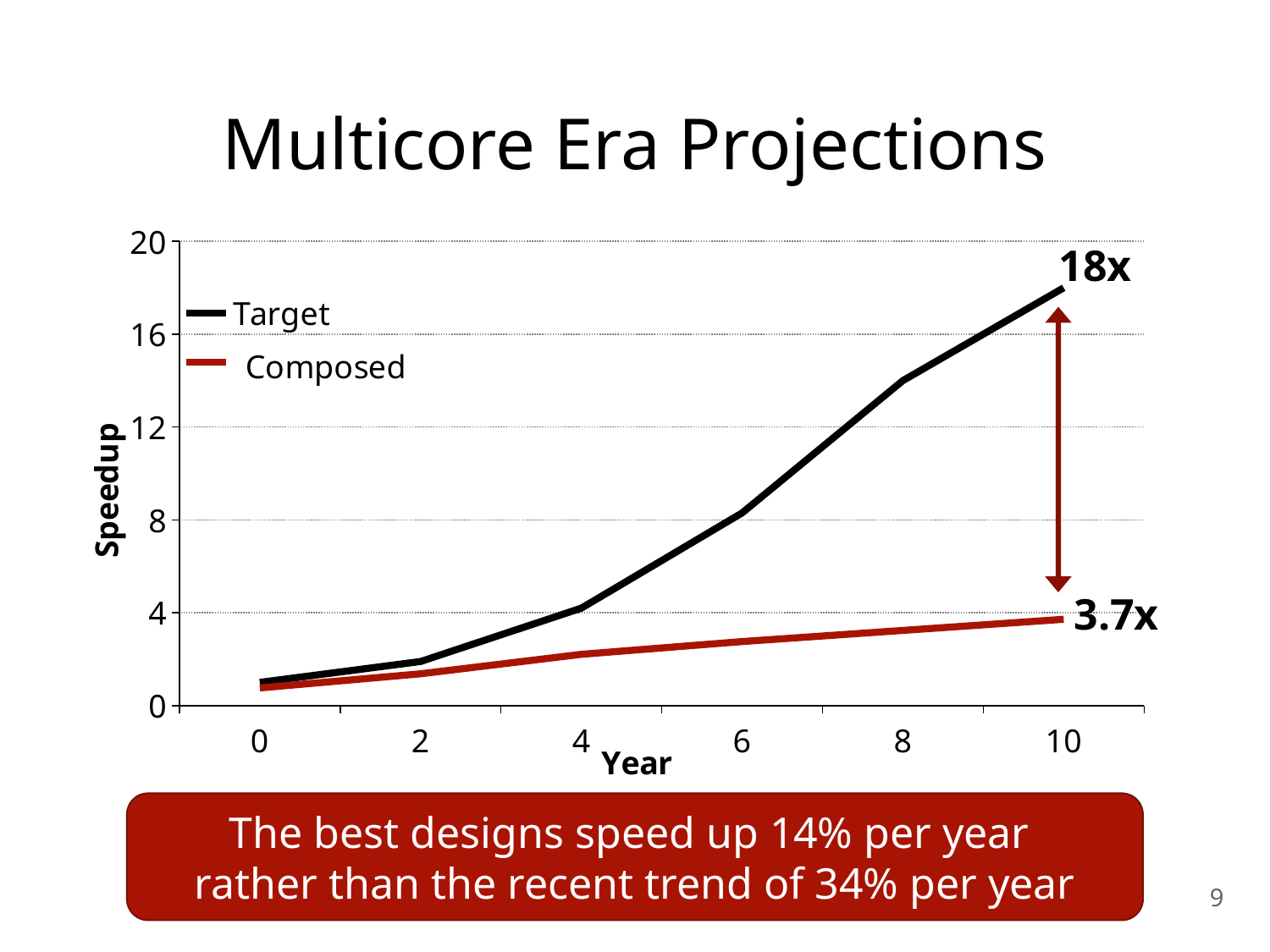
What is the label on the y axis of the chart? Speedup Is the Target speedup at year 2 greater or less than 4? less How many series does the legend list? 2 What speedup does the Composed series reach at year 10? 3.7x Is the Target speedup at year 8 greater or less than 12? greater What is the title of the chart? Multicore Era Projections What is the difference between the Target and Composed speedups at year 10? 14.3x Does the Target speedup rise or fall as the year increases? rises What kind of chart is shown on the slide? line chart What speedup does the Target series reach at year 10? 18x Is the Composed speedup at year 6 greater or less than 4? less Which series has the higher speedup at year 10, Target or Composed? Target